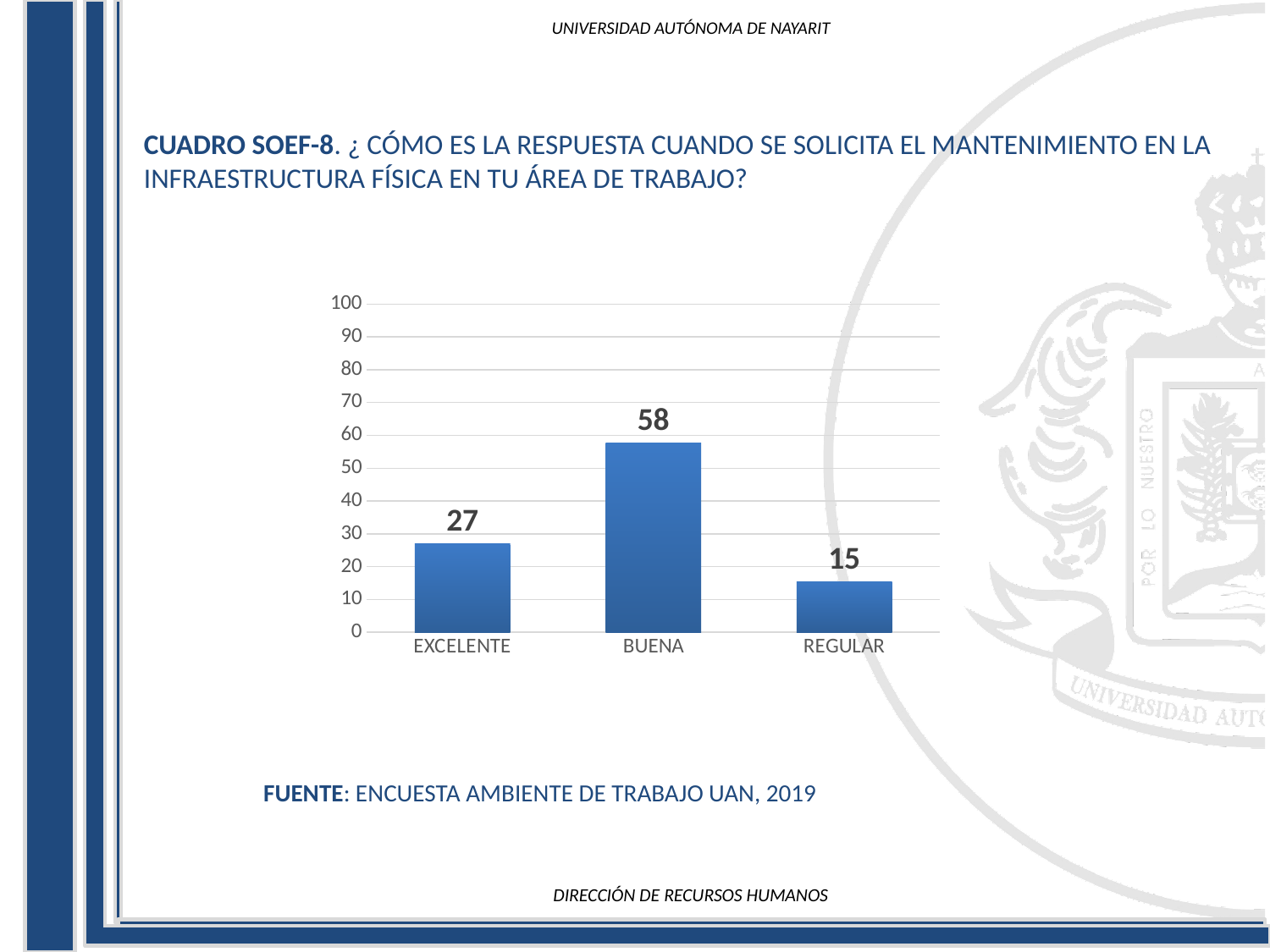
What is the value for REGULAR? 15 What is the value for BUENA? 58 How many categories are shown on the x axis? 3 What is the difference between the values for BUENA and EXCELENTE? 31 Which category has the highest value? BUENA What kind of chart is shown on the slide? bar chart What is the value for EXCELENTE? 27 Is the value for BUENA greater or less than 50? greater Which category has the lowest value? REGULAR What is the difference between the values for EXCELENTE and REGULAR? 12 Which is larger, the value for EXCELENTE or the value for REGULAR? EXCELENTE What is the source cited below the chart? ENCUESTA AMBIENTE DE TRABAJO UAN, 2019